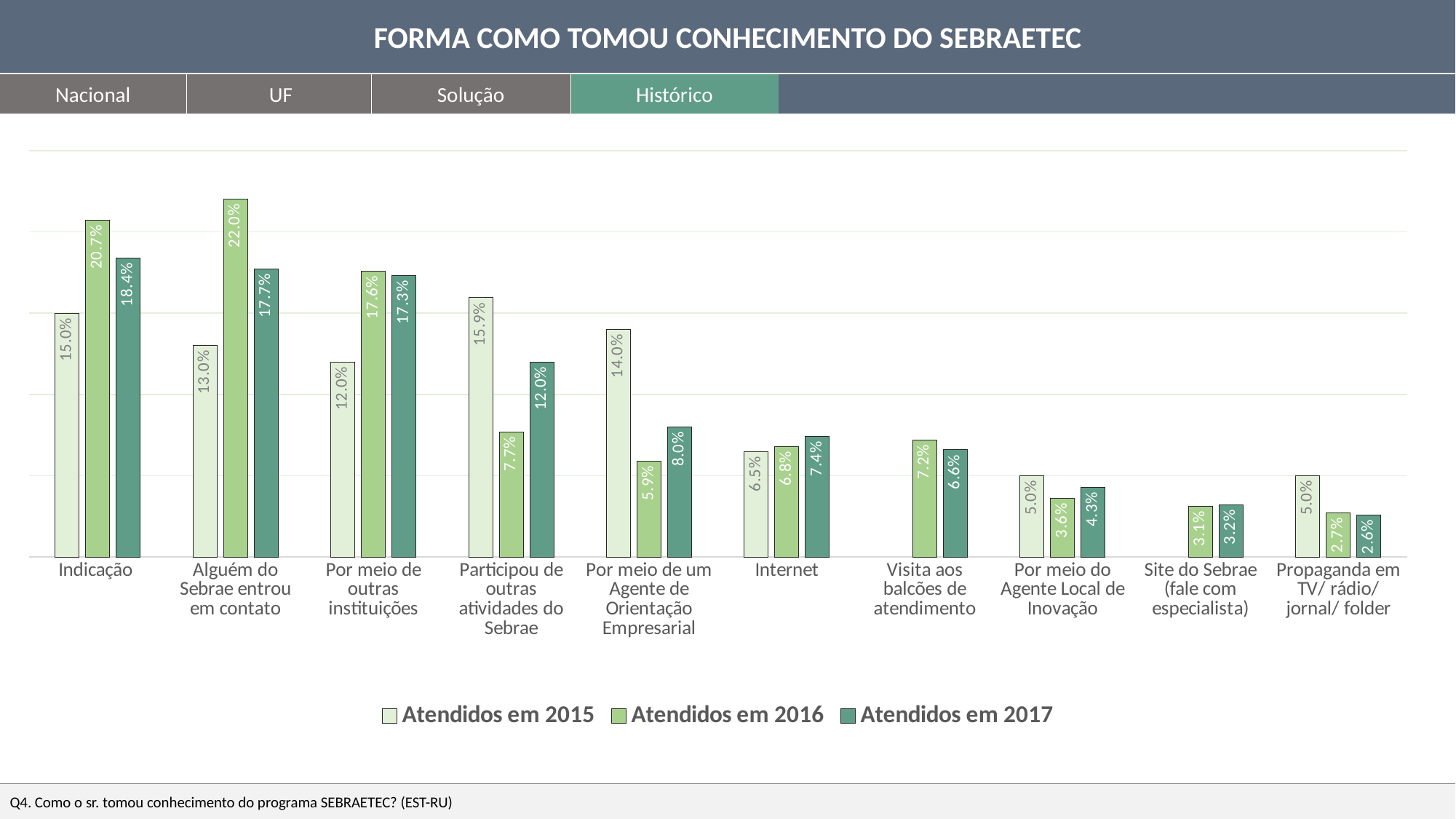
Which category has the lowest value in the Atendidos em 2017 series? Propaganda em TV/ rádio/ jornal/ folder Which category has the highest value in the Atendidos em 2016 series? Alguém do Sebrae entrou em contato What is the difference between the Atendidos em 2016 and Atendidos em 2015 values for Alguém do Sebrae entrou em contato? 9.0% What is the title of the slide containing the chart? FORMA COMO TOMOU CONHECIMENTO DO SEBRAETEC How many series does the legend list? 3 What is the value for Por meio de um Agente de Orientação Empresarial in the Atendidos em 2015 series? 14.0% Which series is shown in the darkest green colour? Atendidos em 2017 How many categories are shown on the x axis? 10 Which is larger for Participou de outras atividades do Sebrae: the Atendidos em 2015 value or the Atendidos em 2017 value? Atendidos em 2015 What kind of chart is shown on the slide? bar chart What is the value for Internet in the Atendidos em 2017 series? 7.4% What is the value for Indicação in the Atendidos em 2016 series? 20.7%